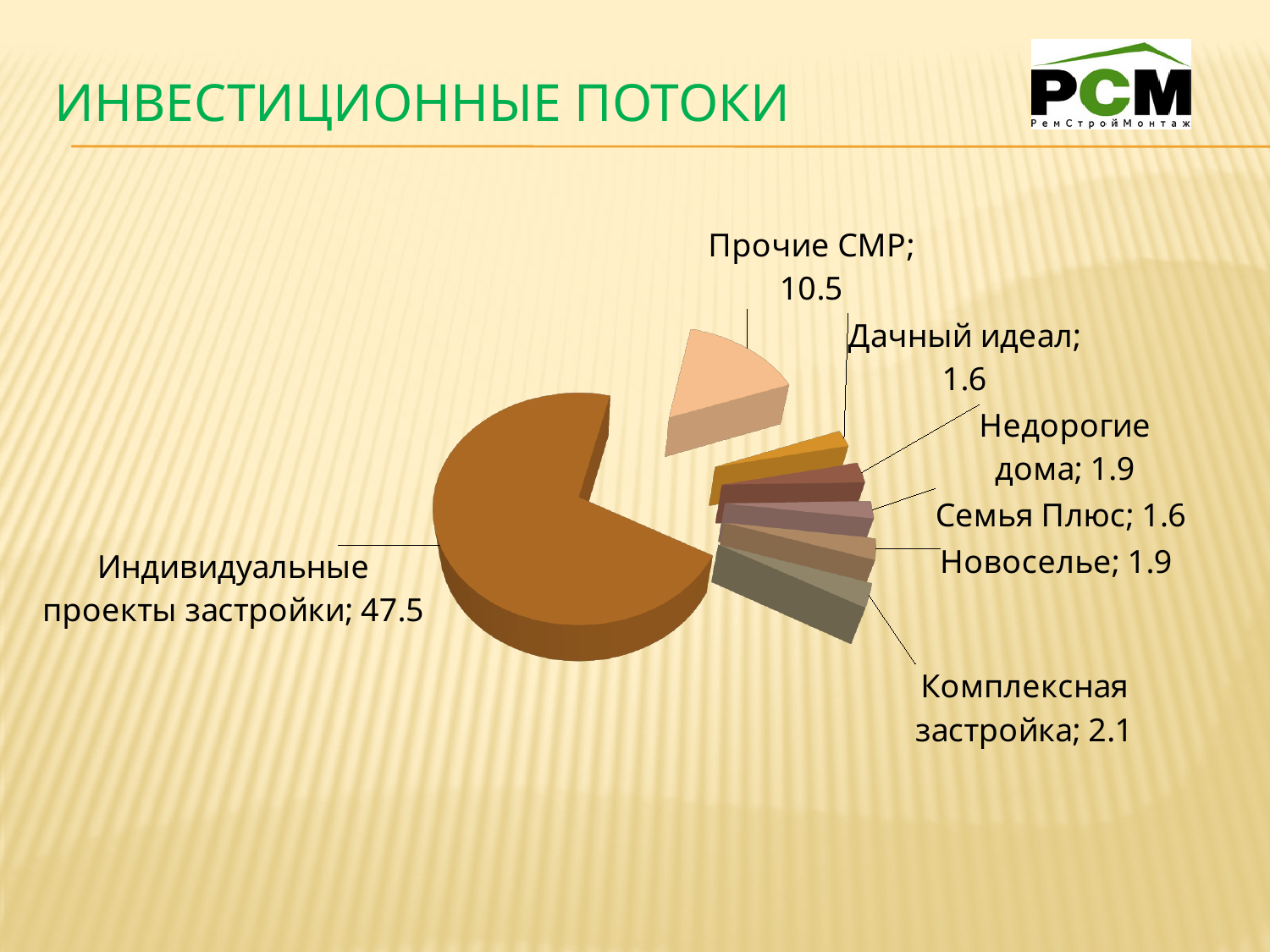
What is the value for Комплексная застройка? 2.1 What is the value for Прочие СМР? 10.5 What is the value for Индивидуальные проекты застройки? 47.5 What is the difference between Прочие СМР and Комплексная застройка? 8.4 What is the difference between Индивидуальные проекты застройки and Прочие СМР? 37 Which category has the largest value? Индивидуальные проекты застройки What is the value for Семья Плюс? 1.6 What kind of chart is shown on the slide? Pie chart What is the title of the slide? ИНВЕСТИЦИОННЫЕ ПОТОКИ What is the value for Недорогие дома? 1.9 Which is larger, Новоселье or Дачный идеал? Новоселье How many categories are shown in the chart? 7